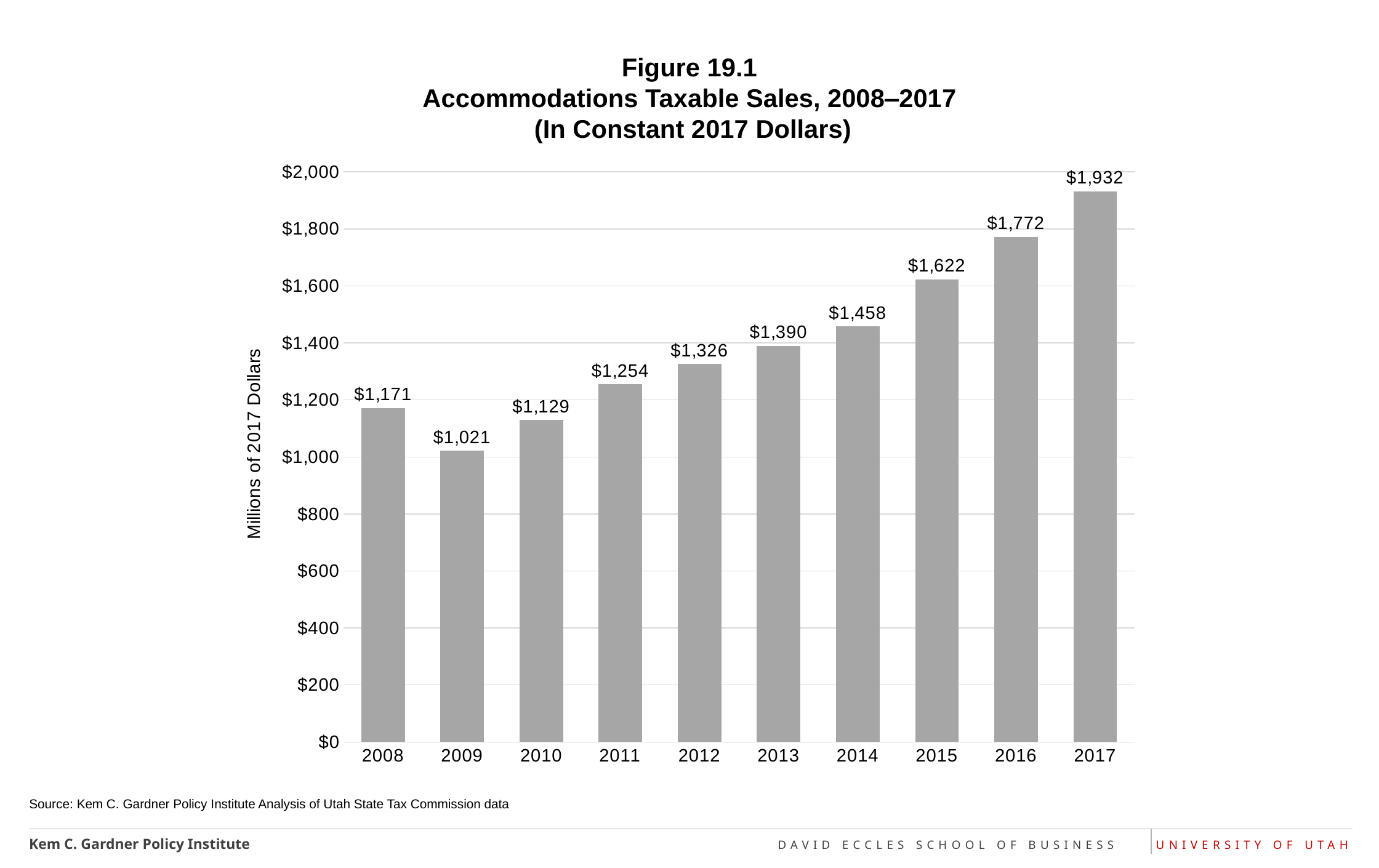
Is the value for 2015 greater or less than $1,600? greater What is the value for 2008? $1,171 What is the difference between the values for 2008 and 2009? $150 What is the value for 2016? $1,772 What is the value for 2013? $1,390 Do the values generally rise or fall from 2009 to 2017? rise Which is larger, the value for 2010 or the value for 2011? 2011 What kind of chart is this? bar chart Which year has the highest value? 2017 What is the difference between the values for 2017 and 2016? $160 Which year has the lowest value? 2009 How many years are shown on the x axis? 10